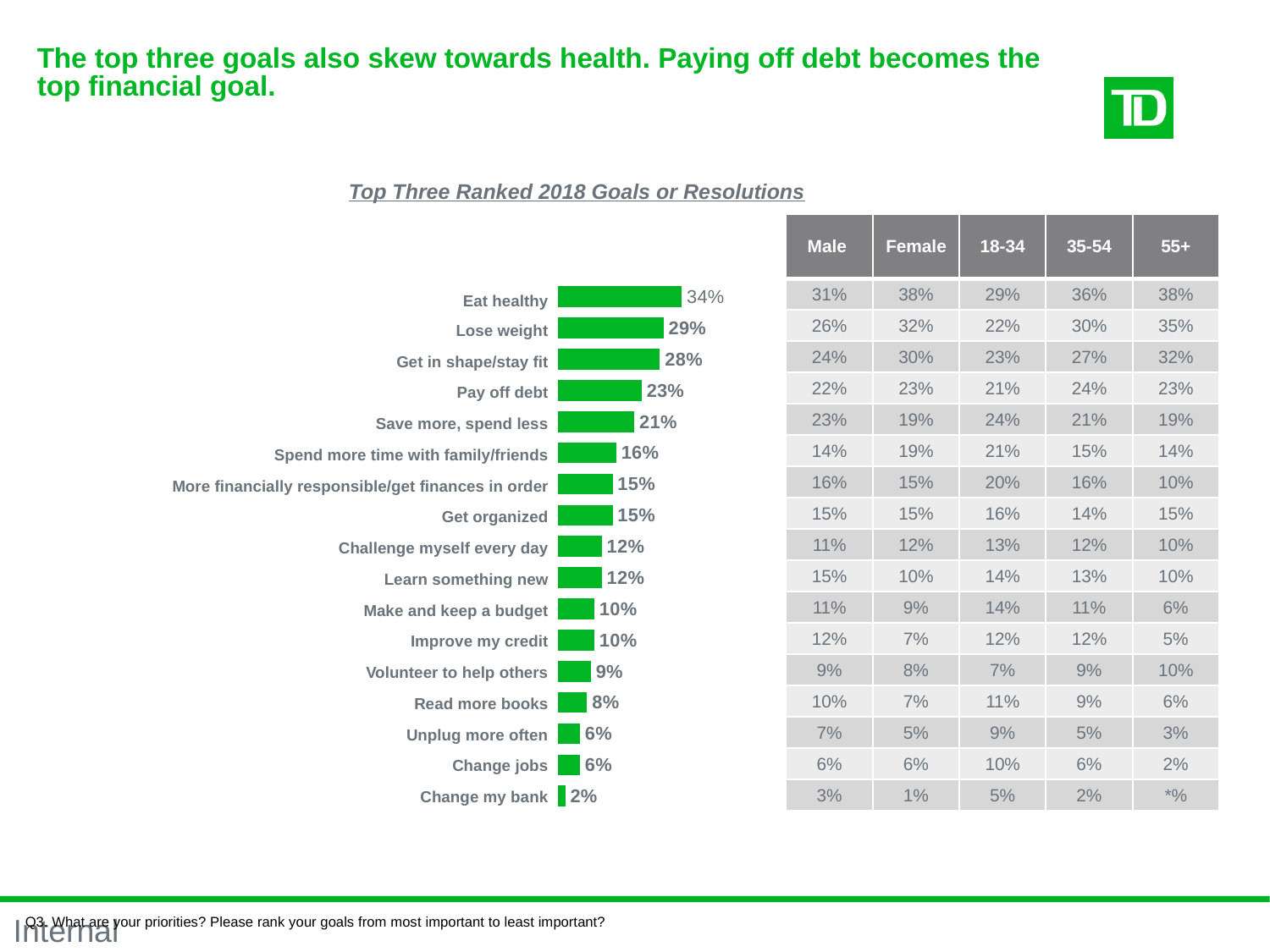
Which category has the lowest value? Change my bank What is the difference between Eat healthy and Lose weight? 5% What is the value for Volunteer to help others? 9% What is the title of the chart? Top Three Ranked 2018 Goals or Resolutions How many categories are shown in the bar chart? 17 Which category has the highest value? Eat healthy What is the value for Pay off debt? 23% What is the value for Eat healthy? 34% Which is larger, Read more books or Make and keep a budget? Make and keep a budget What kind of chart is shown on the slide? bar chart Which is larger, Get in shape/stay fit or Pay off debt? Get in shape/stay fit What is the difference between Save more, spend less and Spend more time with family/friends? 5%